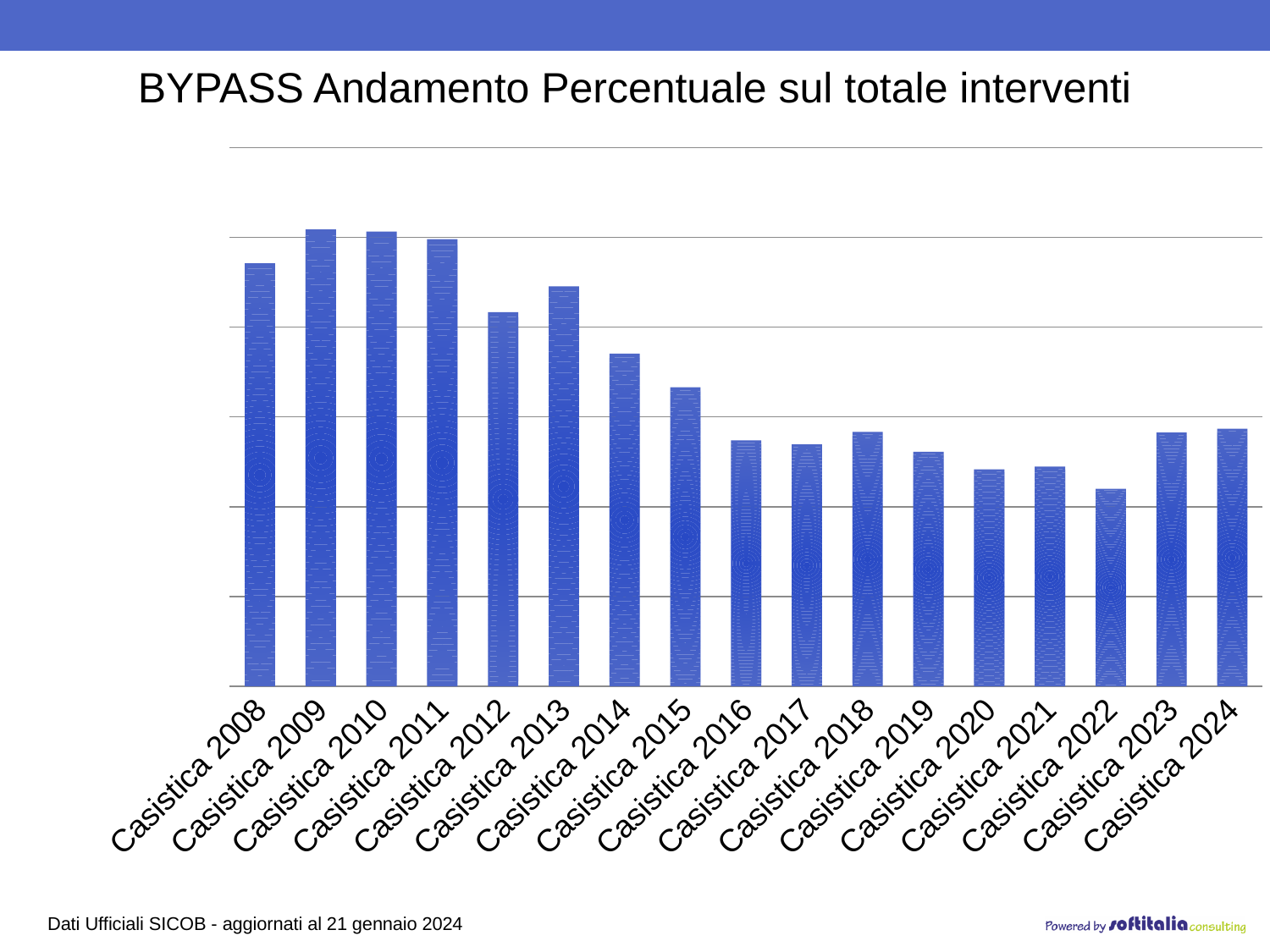
Which is larger, the value for Casistica 2008 or the value for Casistica 2012? Casistica 2008 Which category has the lowest value in the chart? Casistica 2022 Do the values rise or fall from Casistica 2022 to Casistica 2024? rise Which is larger, the value for Casistica 2011 or the value for Casistica 2022? Casistica 2011 Which is larger, the value for Casistica 2013 or the value for Casistica 2015? Casistica 2013 How many categories (bars) are plotted in the chart? 17 Do the values generally rise or fall from Casistica 2009 to Casistica 2022? fall What is the first category shown on the x axis? Casistica 2008 What is the title of the chart? BYPASS Andamento Percentuale sul totale interventi What kind of chart is shown on the slide? bar chart